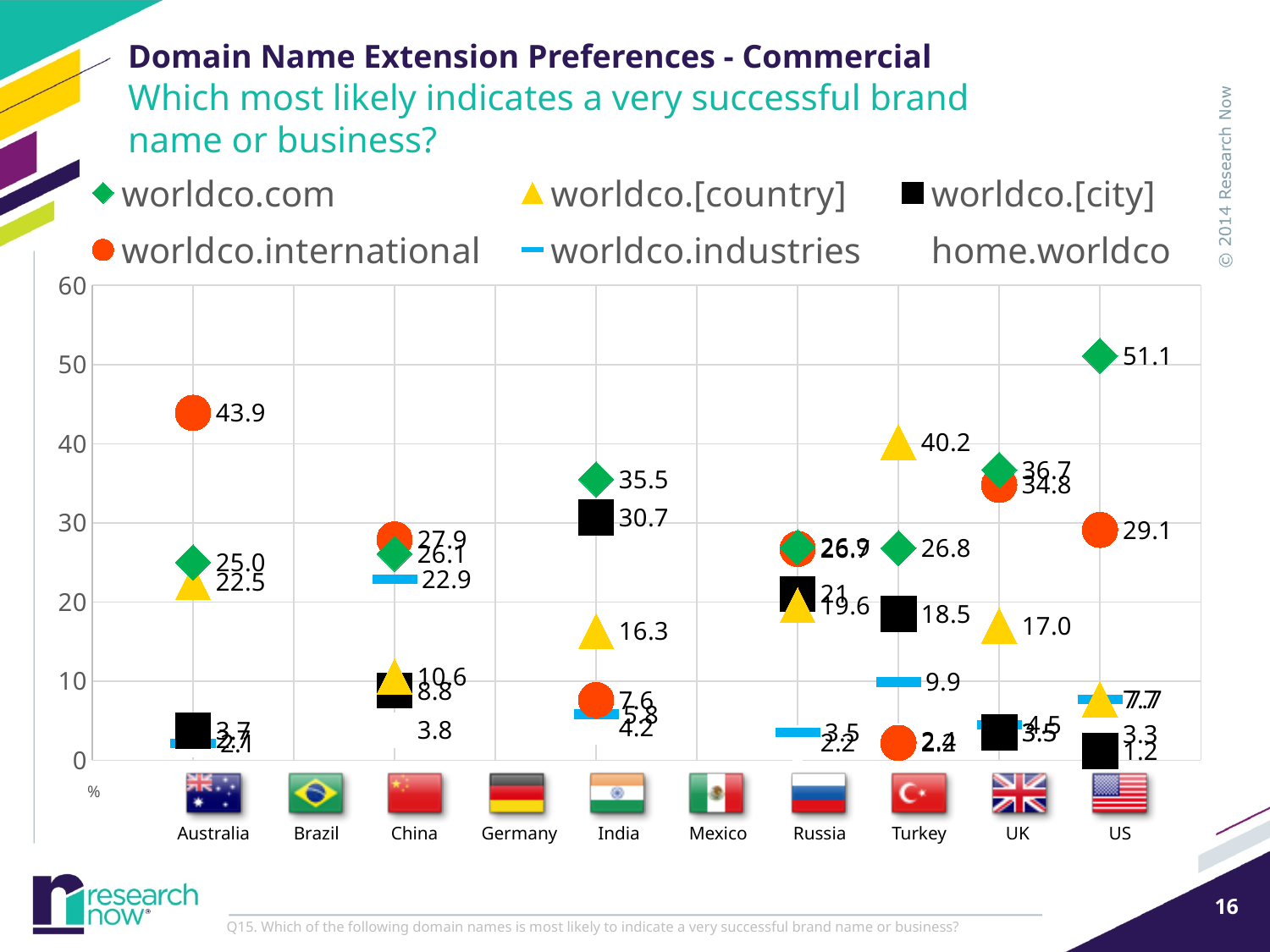
What is the value for worldco.international in Australia? 43.9 Which is larger, the worldco.com value for India or for Turkey? India What is the value for worldco.com in the US? 51.1 Which country has the highest value for worldco.com? US What is the value for worldco.industries in China? 22.9 How many series does the legend list? 6 How many countries are shown on the x axis? 10 What is the value for worldco.[country] in Turkey? 40.2 What is the difference between the worldco.[country] value for Turkey and for the UK? 23.2 Which countries on the x axis have no data points plotted? Brazil, Germany, Mexico What is the value for worldco.[city] in India? 30.7 What kind of chart is shown on the slide? Scatter chart